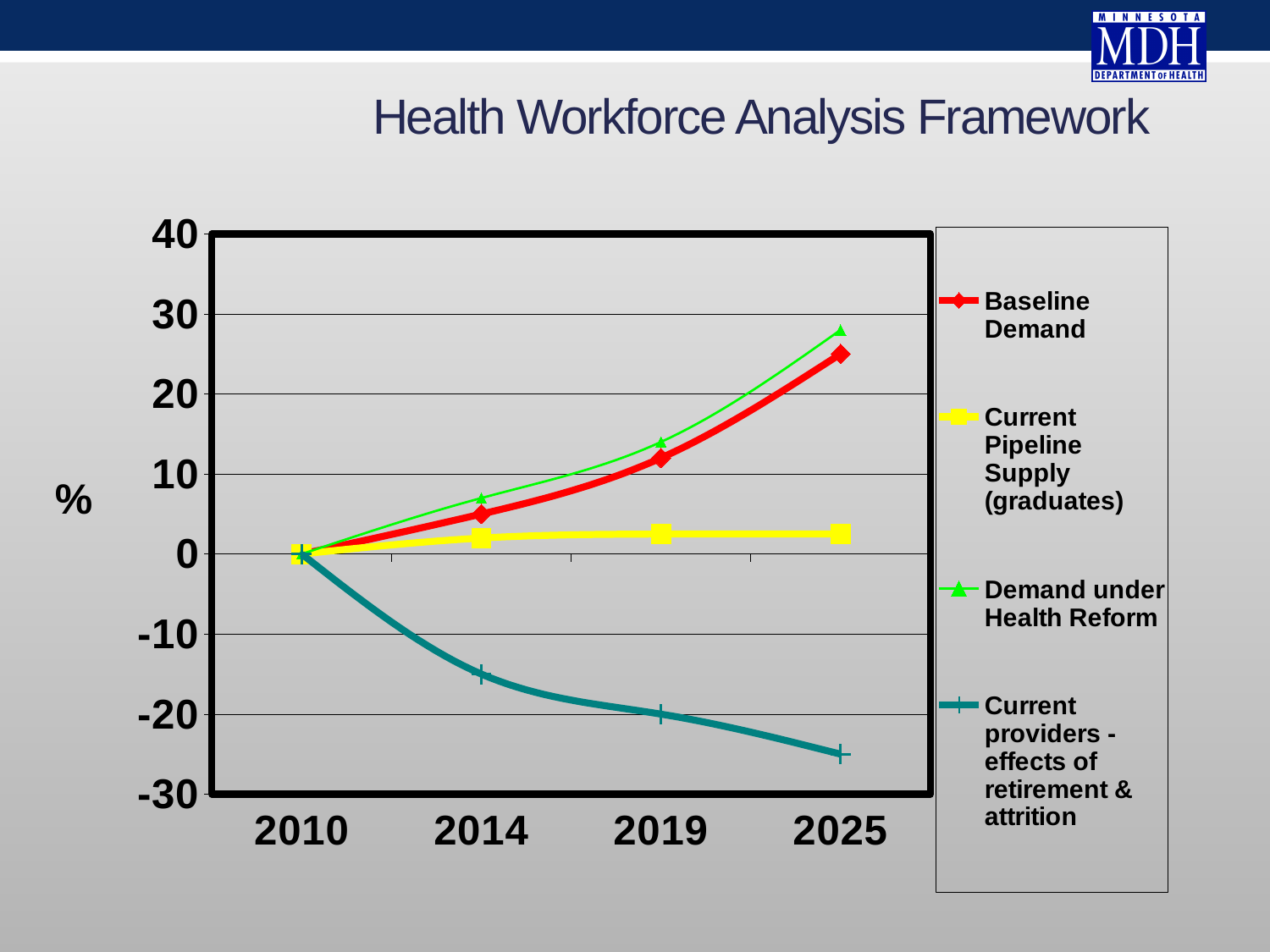
Is the value for Baseline Demand in 2025 greater or less than 20? greater How many series does the legend list? 4 Does the Baseline Demand line rise or fall from 2010 to 2025? rises Which series has the highest value in 2025? Demand under Health Reform How many years are labelled on the x axis? 4 Does the Current providers - effects of retirement & attrition line rise or fall from 2010 to 2025? falls What kind of chart is shown on the slide? line chart What is the value for Baseline Demand in 2010? 0 What unit is shown on the y axis label? % In 2019, which is larger: Demand under Health Reform or Current Pipeline Supply (graduates)? Demand under Health Reform Is the value for Current providers - effects of retirement & attrition in 2014 greater or less than -10? less Which series has the lowest value in 2025? Current providers - effects of retirement & attrition